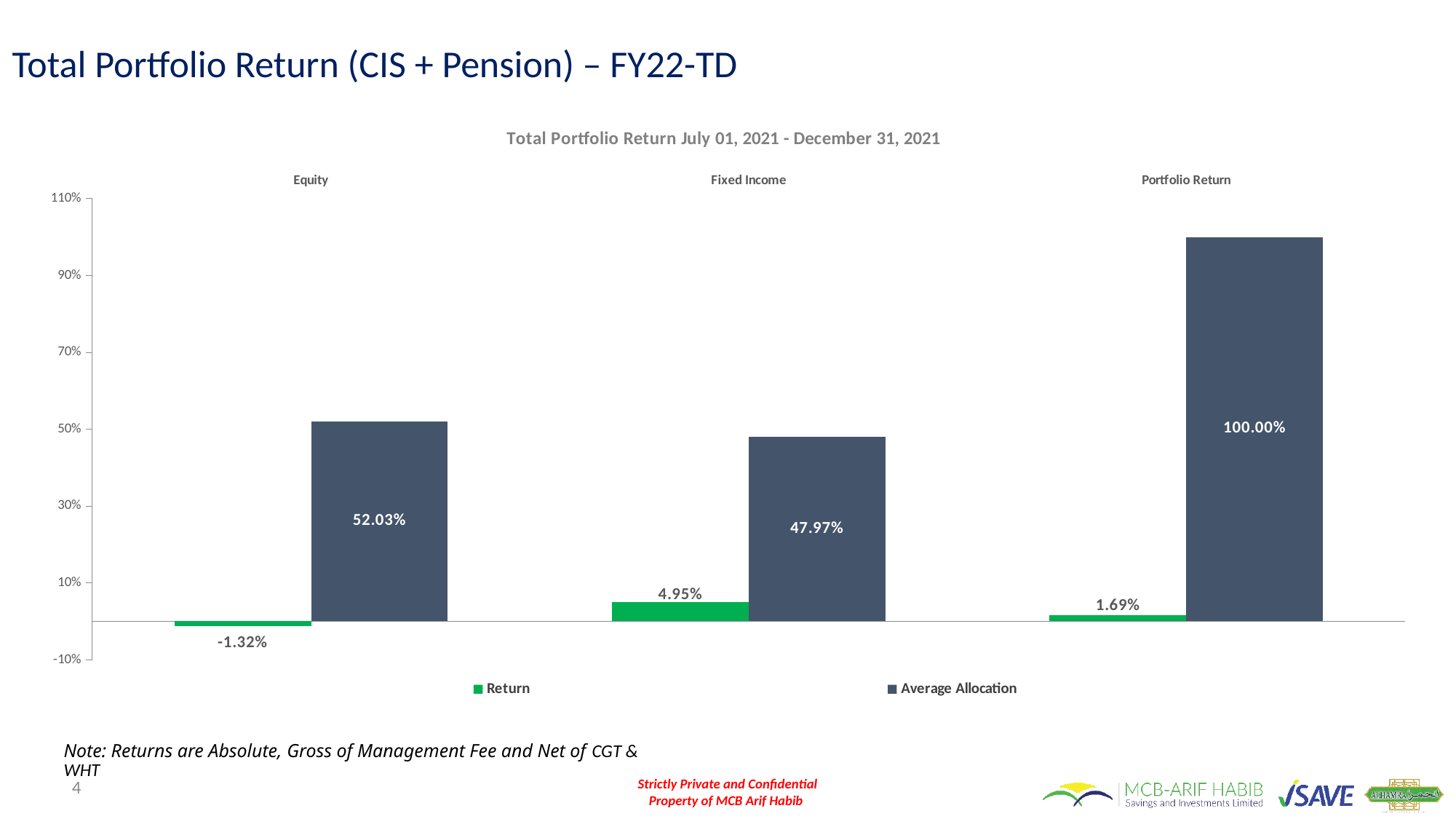
How many series does the legend list? 2 What is the Average Allocation for Equity? 52.03% What is the difference between the Average Allocation for Equity and for Fixed Income? 4.06% How many categories are shown on the x axis? 3 What is the Return value for Equity? -1.32% Which category has the highest Return value? Fixed Income What is the Average Allocation for Fixed Income? 47.97% What is the Return value for Portfolio Return? 1.69% Which is larger, the Return for Fixed Income or the Return for Portfolio Return? Fixed Income What kind of chart is shown on the slide? Bar chart What is the title of the chart? Total Portfolio Return July 01, 2021 - December 31, 2021 Which category has the lowest Return value? Equity